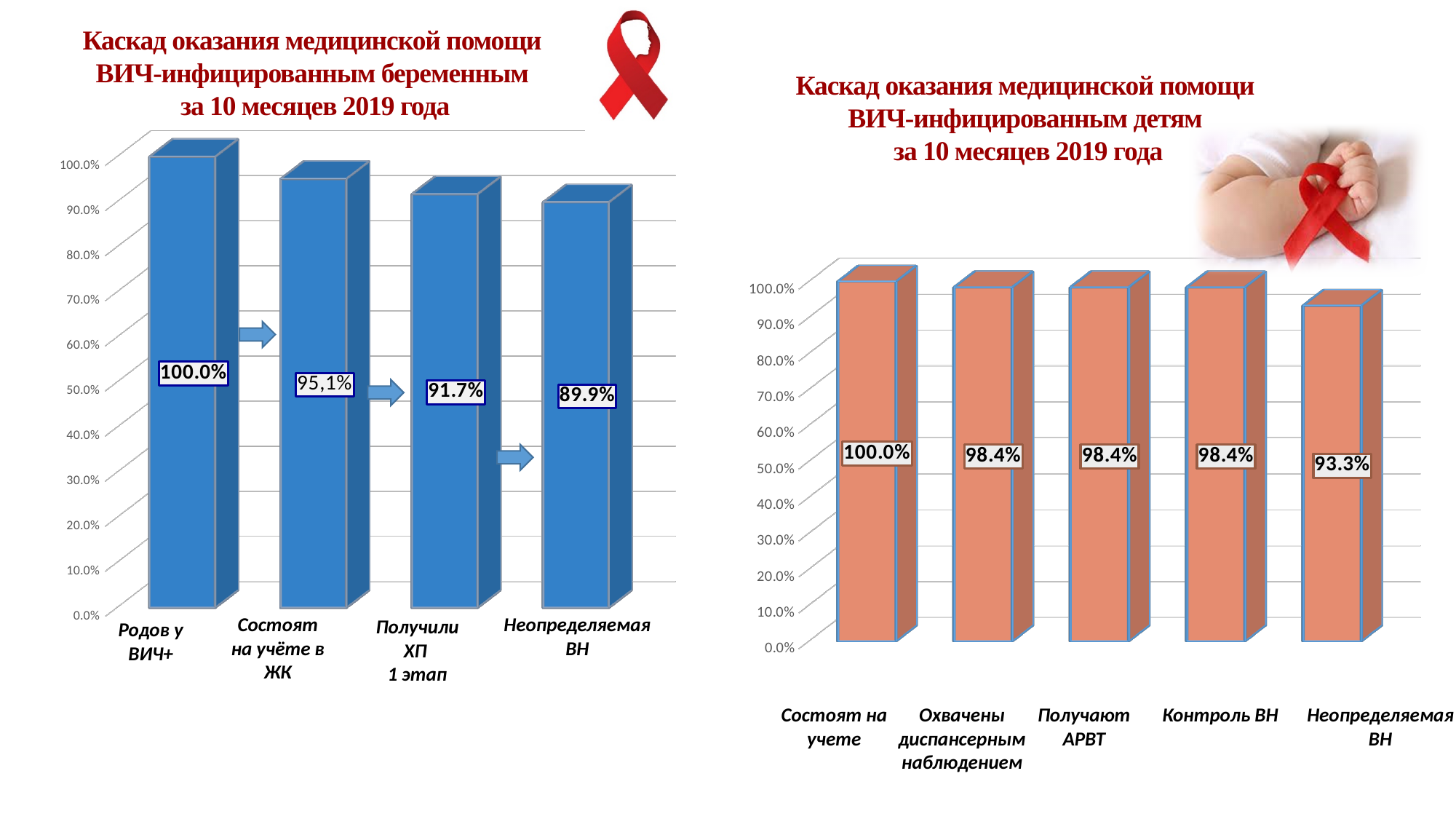
On the right chart (ВИЧ-инфицированным детям), how many categories are shown? 5 On the right chart (ВИЧ-инфицированным детям), which category has the highest value? Состоят на учете On the left chart (ВИЧ-инфицированным беременным), which category has the lowest value? Неопределяемая ВН What type of chart is the right chart (ВИЧ-инфицированным детям)? bar chart On the left chart (ВИЧ-инфицированным беременным), do the values rise or fall from left to right? fall On the right chart (ВИЧ-инфицированным детям), what is the value for 'Получают АРВТ'? 98.4% On the left chart (ВИЧ-инфицированным беременным), how many categories are shown? 4 On the right chart (ВИЧ-инфицированным детям), what is the difference between 'Состоят на учете' and 'Неопределяемая ВН'? 6.7% On the right chart (ВИЧ-инфицированным детям), what is the value for 'Неопределяемая ВН'? 93.3% On the left chart (ВИЧ-инфицированным беременным), what is the value for 'Состоят на учёте в ЖК'? 95,1% On the left chart (ВИЧ-инфицированным беременным), what is the value for 'Получили ХП 1 этап'? 91.7% On the left chart (ВИЧ-инфицированным беременным), what is the value for 'Неопределяемая ВН'? 89.9%